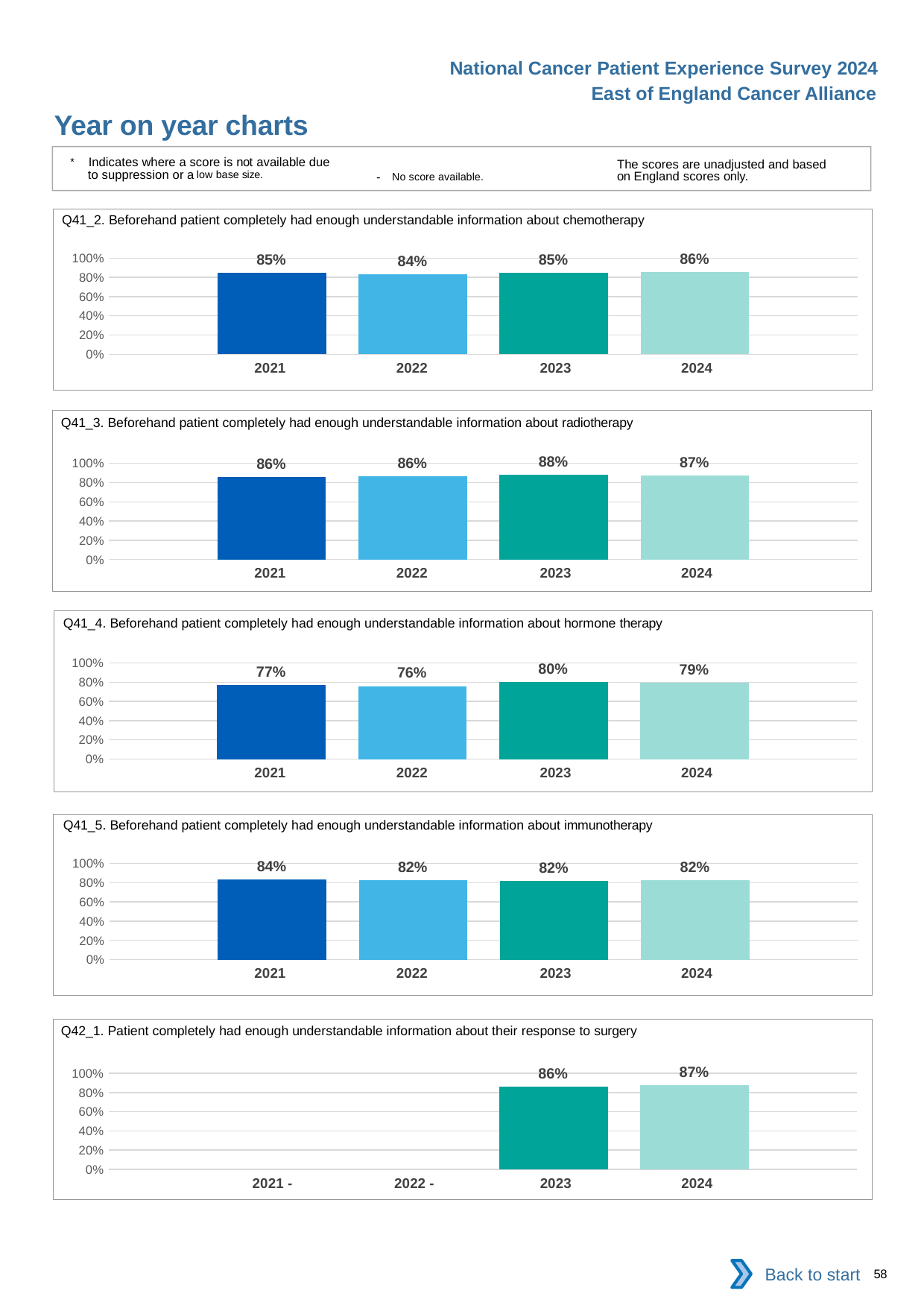
In the Q41_3 chart (radiotherapy), which year has the highest value? 2023 What kind of chart is the Q41_5 chart (immunotherapy)? bar chart In the Q41_3 chart (radiotherapy), is the value for 2024 larger or smaller than the value for 2023? smaller In the Q41_3 chart (radiotherapy), what is the difference between the 2023 value and the 2021 value? 2% In the Q41_2 chart (chemotherapy), what is the value for 2024? 86% In the Q41_4 chart (hormone therapy), which year has the lowest value? 2022 In the Q41_4 chart (hormone therapy), is the value for 2021 greater or less than 80%? less In the Q41_2 chart (chemotherapy), how many years are shown on the x axis? 4 In the Q42_1 chart (response to surgery), what is the value for 2023? 86% In the Q41_4 chart (hormone therapy), what is the value for 2022? 76% In the Q42_1 chart (response to surgery), how many years have a score plotted? 2 In the Q41_5 chart (immunotherapy), what is the difference between the 2021 value and the 2024 value? 2%